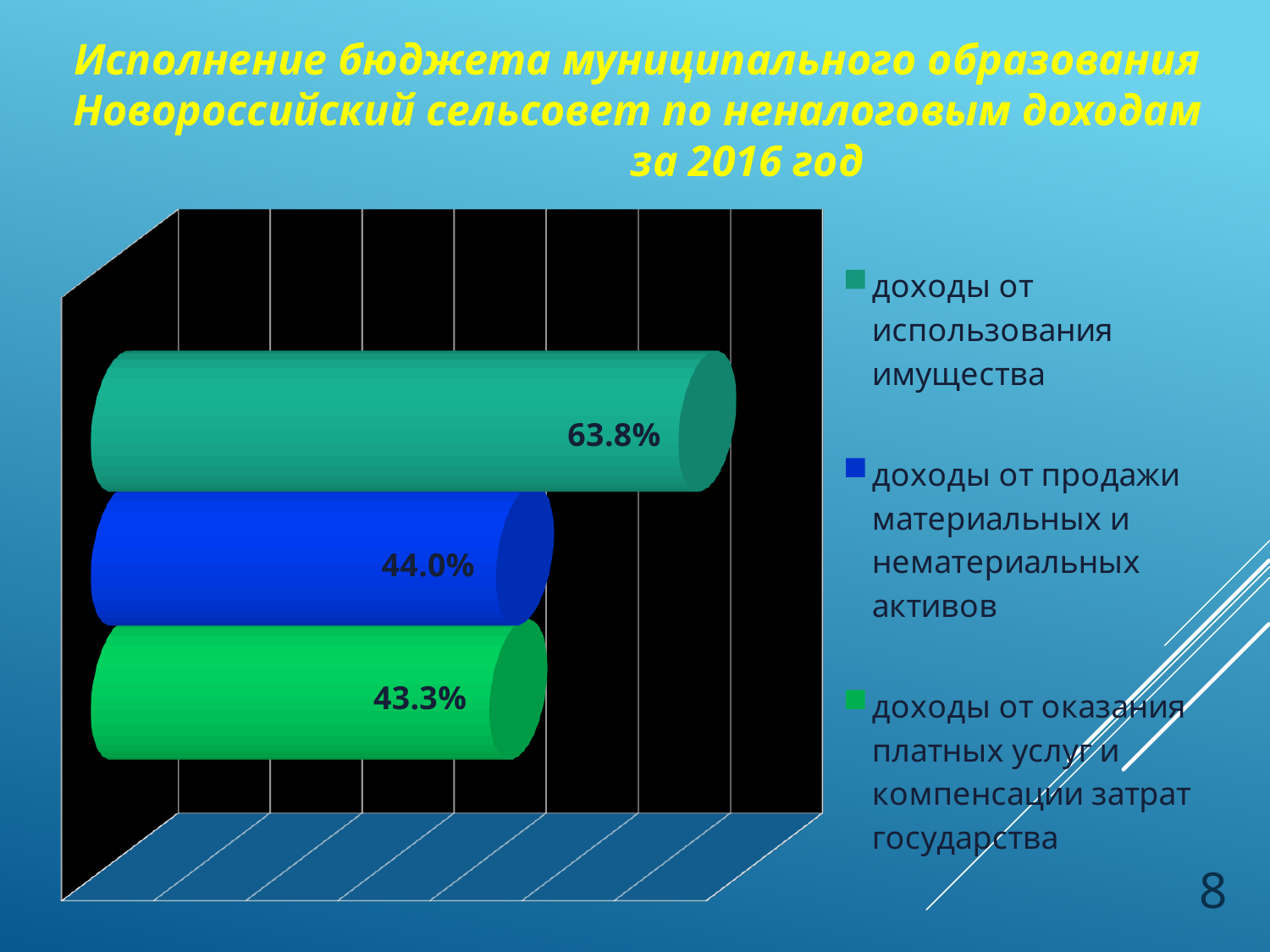
Which is larger: the value for доходы от использования имущества or the value for доходы от оказания платных услуг и компенсации затрат государства? доходы от использования имущества How many bars are plotted on the chart? 3 What is the value for доходы от продажи материальных и нематериальных активов? 44.0% Which year does the slide title say the data is for? 2016 What is the difference between the value for доходы от продажи материальных и нематериальных активов and the value for доходы от оказания платных услуг и компенсации затрат государства? 0.7% What is the difference between the value for доходы от использования имущества and the value for доходы от продажи материальных и нематериальных активов? 19.8% What kind of chart is shown on the slide? bar chart How many entries does the legend list? 3 What is the value for доходы от оказания платных услуг и компенсации затрат государства? 43.3% What is the value for доходы от использования имущества? 63.8% Which category has the lowest value? доходы от оказания платных услуг и компенсации затрат государства Which category has the highest value? доходы от использования имущества